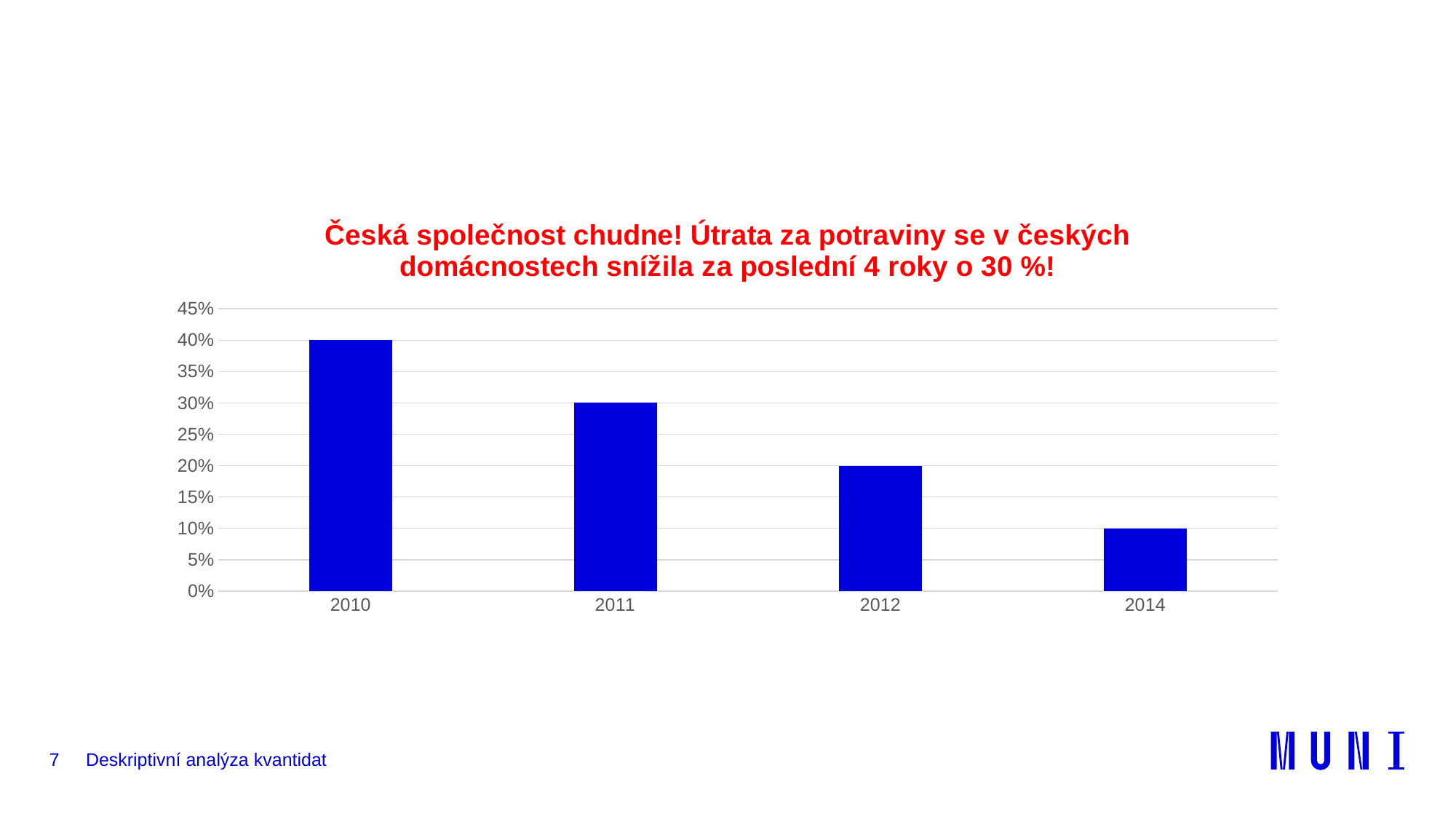
Which is larger, the value for 2011 or the value for 2012? 2011 What is the value for 2012? 20% Do the values rise or fall from 2010 to 2014? fall Which year has the lowest value? 2014 What is the difference between the values for 2010 and 2014? 30% What is the value for 2014? 10% Is the value for 2012 greater or less than 25%? less What is the value for 2010? 40% Which year has the highest value? 2010 What is the value for 2011? 30% How many years are shown on the x axis? 4 What kind of chart is shown on the slide? bar chart